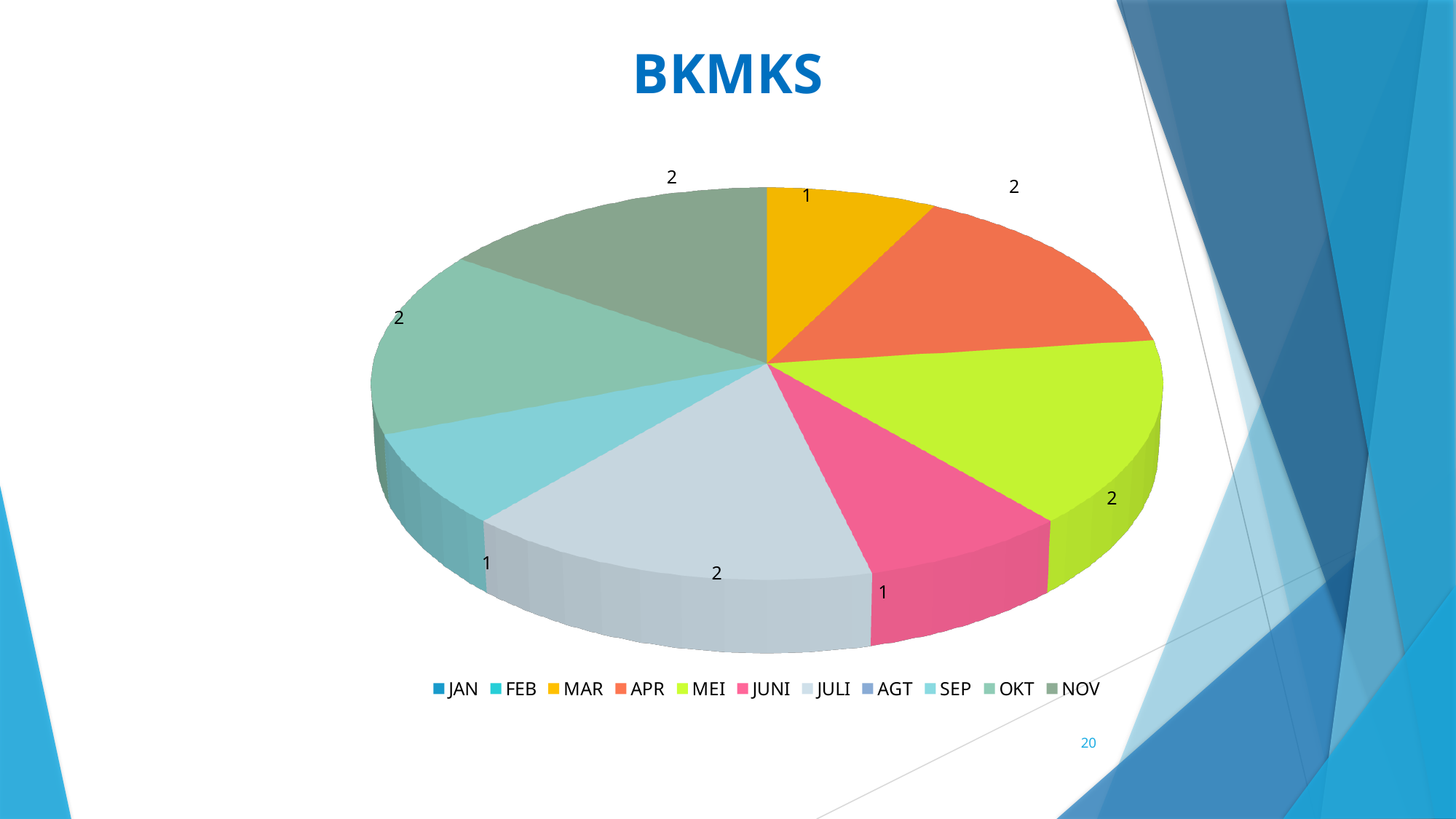
What is the value for NOV? 2 What is the value for SEP? 1 What type of chart is shown on the slide? pie chart What is the value for JUNI? 1 How many slices with data labels are visible in the pie? 8 Which is larger, the value for APR or the value for MAR? APR How many entries does the legend list? 11 What is the title of the chart? BKMKS What is the value for JULI? 2 What is the value for APR? 2 What is the difference between the value for MEI and the value for JUNI? 1 What is the value for MAR? 1